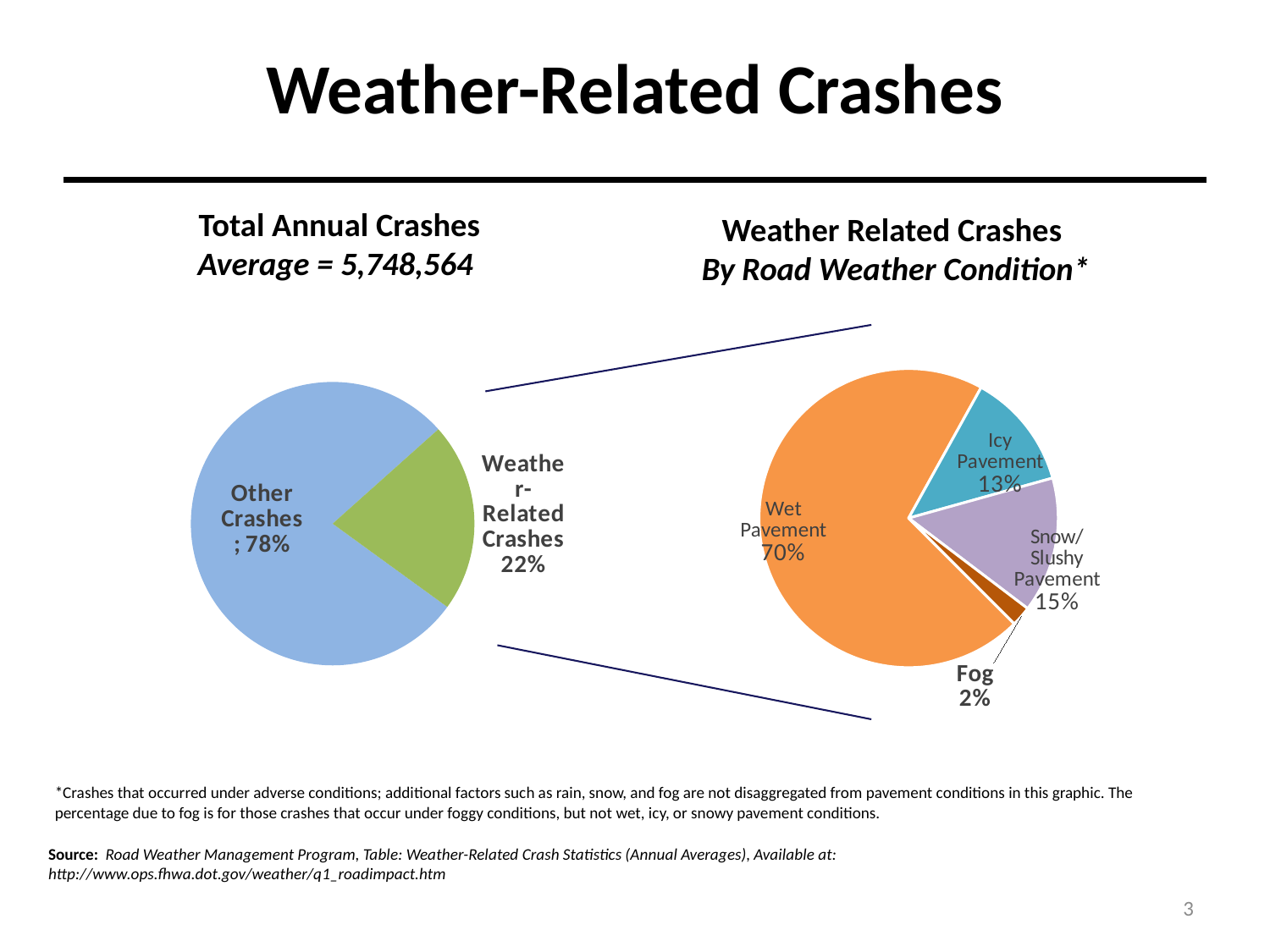
In the Weather Related Crashes By Road Weather Condition chart, which condition has the smallest share? Fog In the Weather Related Crashes By Road Weather Condition chart, how many slices does the pie have? 4 In the Weather Related Crashes By Road Weather Condition chart, what is the difference in percentage points between Snow/Slushy Pavement and Icy Pavement? 2 What kind of chart is the Total Annual Crashes chart? Pie chart In the Weather Related Crashes By Road Weather Condition chart, what percentage is Snow/Slushy Pavement? 15% In the Weather Related Crashes By Road Weather Condition chart, which condition has the largest share? Wet Pavement In the Weather Related Crashes By Road Weather Condition chart, what percentage is Icy Pavement? 13% In the Weather Related Crashes By Road Weather Condition chart, what percentage is Fog? 2% In the Weather Related Crashes By Road Weather Condition chart, which is larger, Icy Pavement or Snow/Slushy Pavement? Snow/Slushy Pavement In the Total Annual Crashes chart, what share of crashes is Weather-Related Crashes? 22% In the Weather Related Crashes By Road Weather Condition chart, what percentage is Wet Pavement? 70% In the Total Annual Crashes chart, what share of crashes is Other Crashes? 78%